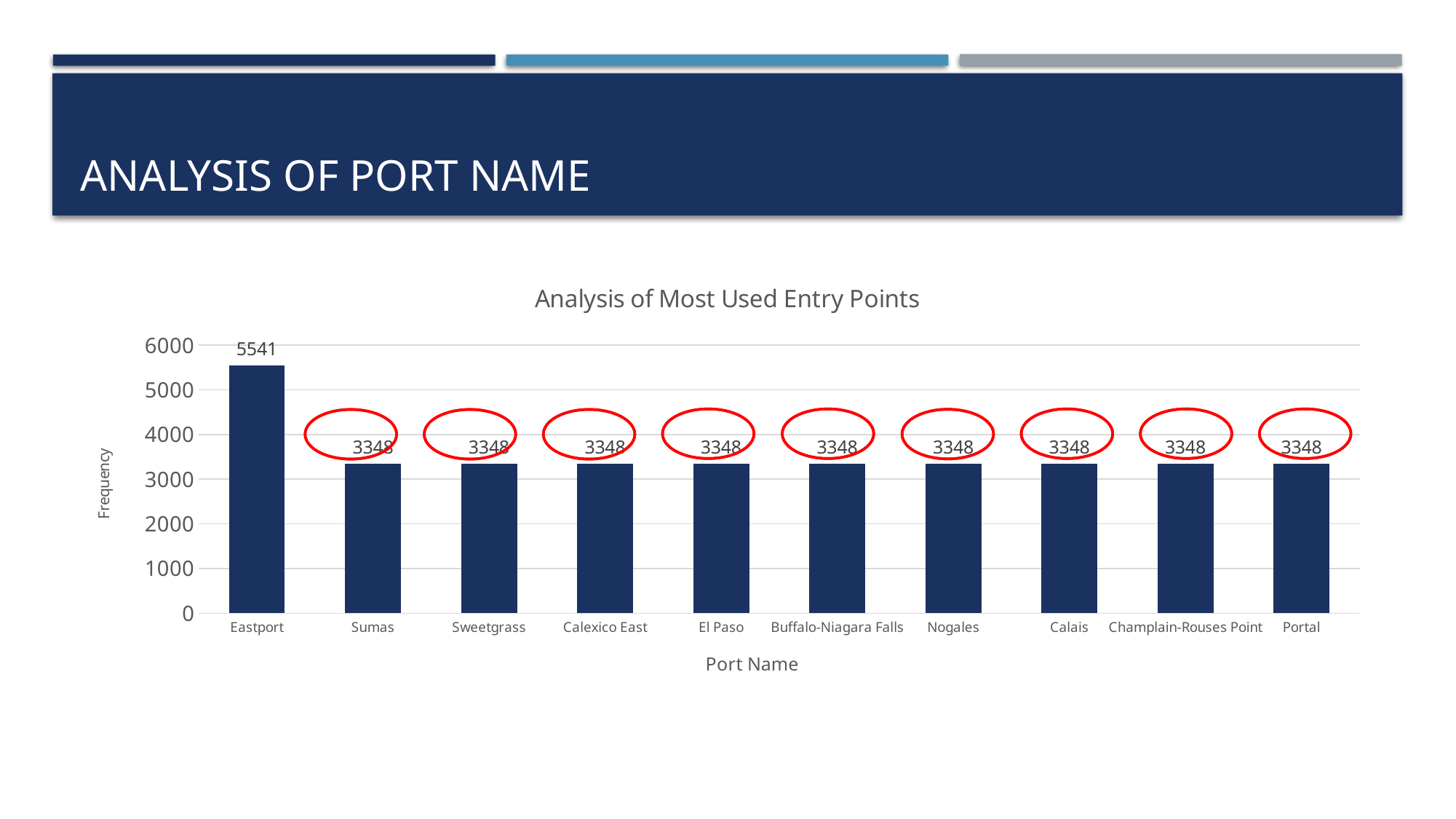
What kind of chart is shown? bar chart What is the title of the chart? Analysis of Most Used Entry Points What is the value for Eastport? 5541 What is the label of the y axis? Frequency What is the value for Buffalo-Niagara Falls? 3348 What is the difference between the values for Eastport and Portal? 2193 Which is larger, the value for Eastport or the value for Calais? Eastport What is the value for Sumas? 3348 Is the value for Nogales greater or less than 4000? less Is the value for Eastport greater or less than 5000? greater How many ports are shown on the x axis? 10 Which port has the highest frequency? Eastport